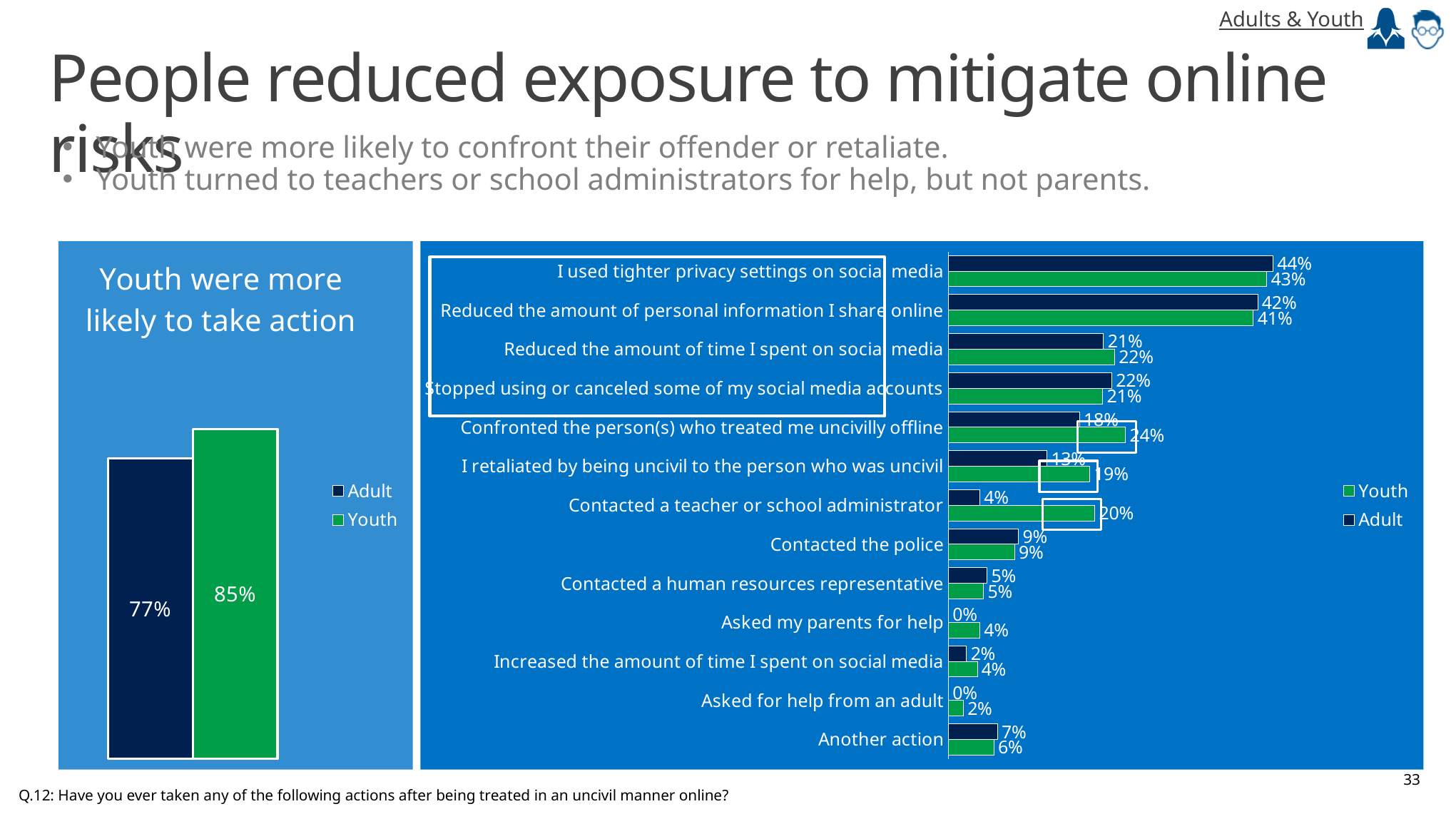
How many series does the legend of the right chart list? 2 In the right chart, what is the difference between the Youth and Adult values for 'Contacted a teacher or school administrator'? 16% In the right chart, which category has the highest Adult value? I used tighter privacy settings on social media In the left chart titled 'Youth were more likely to take action', what is the value for Adult? 77% How many categories are shown in the right chart? 13 In the right chart, which is larger for 'Asked my parents for help': the Adult value or the Youth value? Youth In the left chart titled 'Youth were more likely to take action', what is the difference between the Youth and Adult values? 8% In the left chart titled 'Youth were more likely to take action', what is the value for Youth? 85% What kind of chart is the right chart? Bar chart In the right chart, what is the Youth value for 'Confronted the person(s) who treated me uncivilly offline'? 24% In the right chart, what is the Adult value for 'I used tighter privacy settings on social media'? 44% In the right chart, what is the Youth value for 'Contacted a teacher or school administrator'? 20%